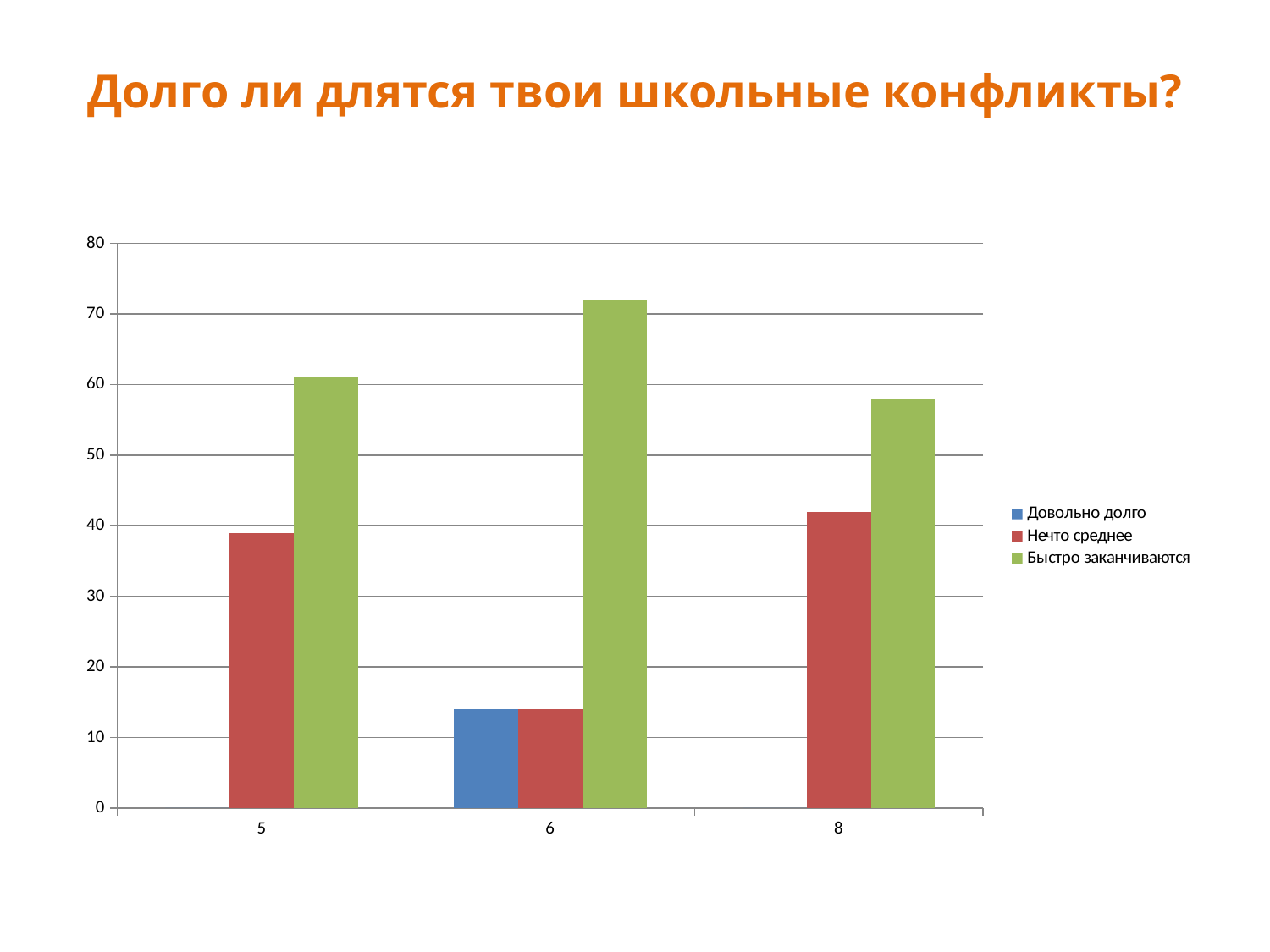
Which category has the lowest value for the series "Нечто среднее"? 6 What kind of chart is shown on the slide? bar chart Is the value for "Быстро заканчиваются" in category 6 greater or less than 70? greater What is the title of the chart? Долго ли длятся твои школьные конфликты? How many series does the legend list? 3 Which category has the lowest value for the series "Быстро заканчиваются"? 8 Which is larger in category 8: "Нечто среднее" or "Быстро заканчиваются"? Быстро заканчиваются Is the value for "Довольно долго" in category 6 greater or less than 20? less How many categories are shown on the x axis? 3 Which category has the highest value for the series "Быстро заканчиваются"? 6 Is the value for "Быстро заканчиваются" in category 8 greater or less than 50? greater